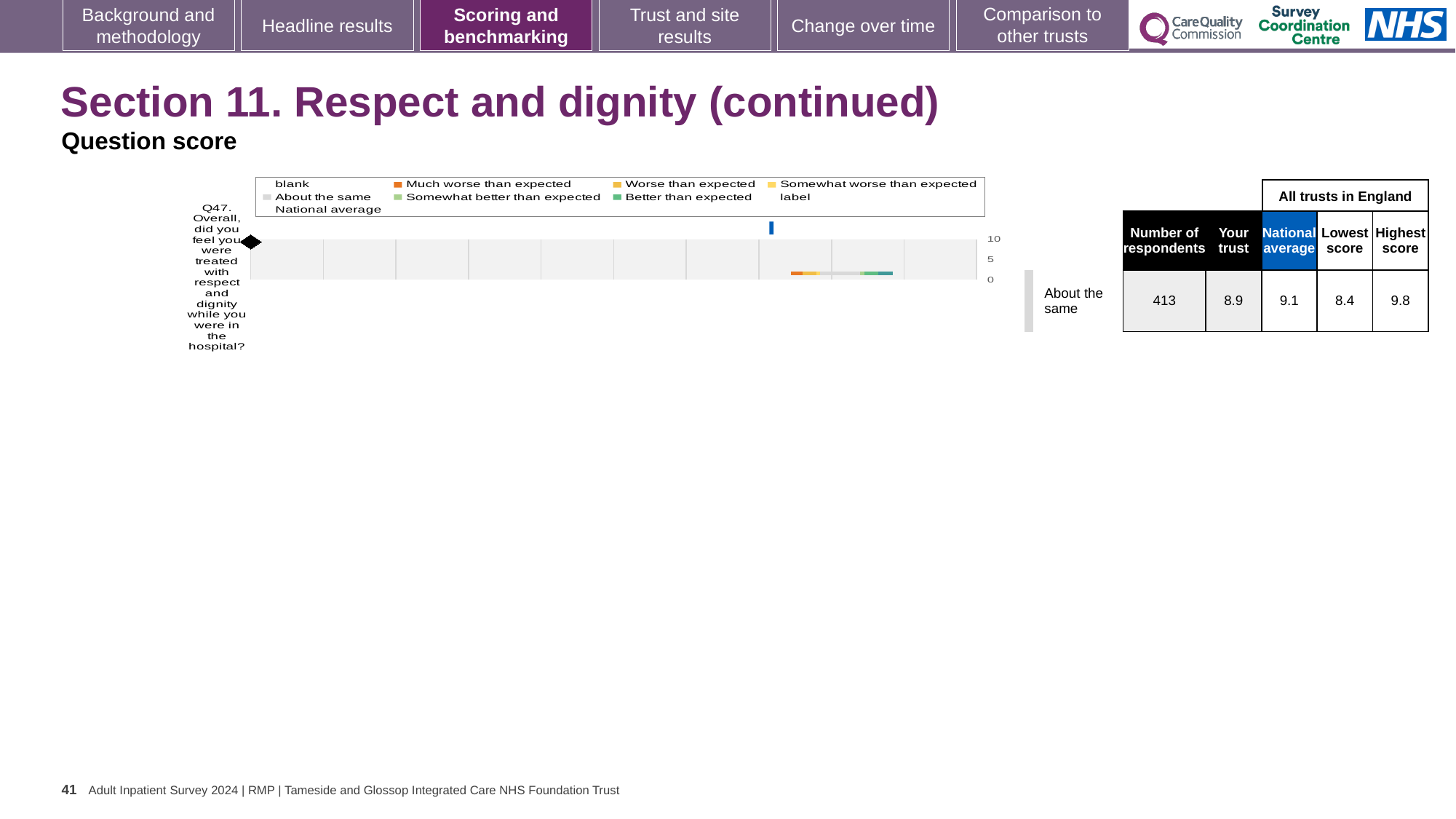
What benchmarking category is the trust's Q47 result placed in? About the same Is the trust's score for Q47 greater or less than 5 on the chart axis? greater What is the highest score among all trusts in England for Q47? 9.8 What is the maximum value shown on the chart's vertical axis? 10 What is the lowest score among all trusts in England for Q47? 8.4 What is the difference between the highest and lowest scores for Q47 across all trusts in England? 1.4 What is the difference between the national average and the trust's score for Q47? 0.2 What is the national average score for Q47? 9.1 How many respondents answered Q47? 413 What is the 'Your trust' score for Q47 shown on the slide? 8.9 How many questions are plotted on the chart? 1 Which is larger for Q47, the trust's score or the national average? National average